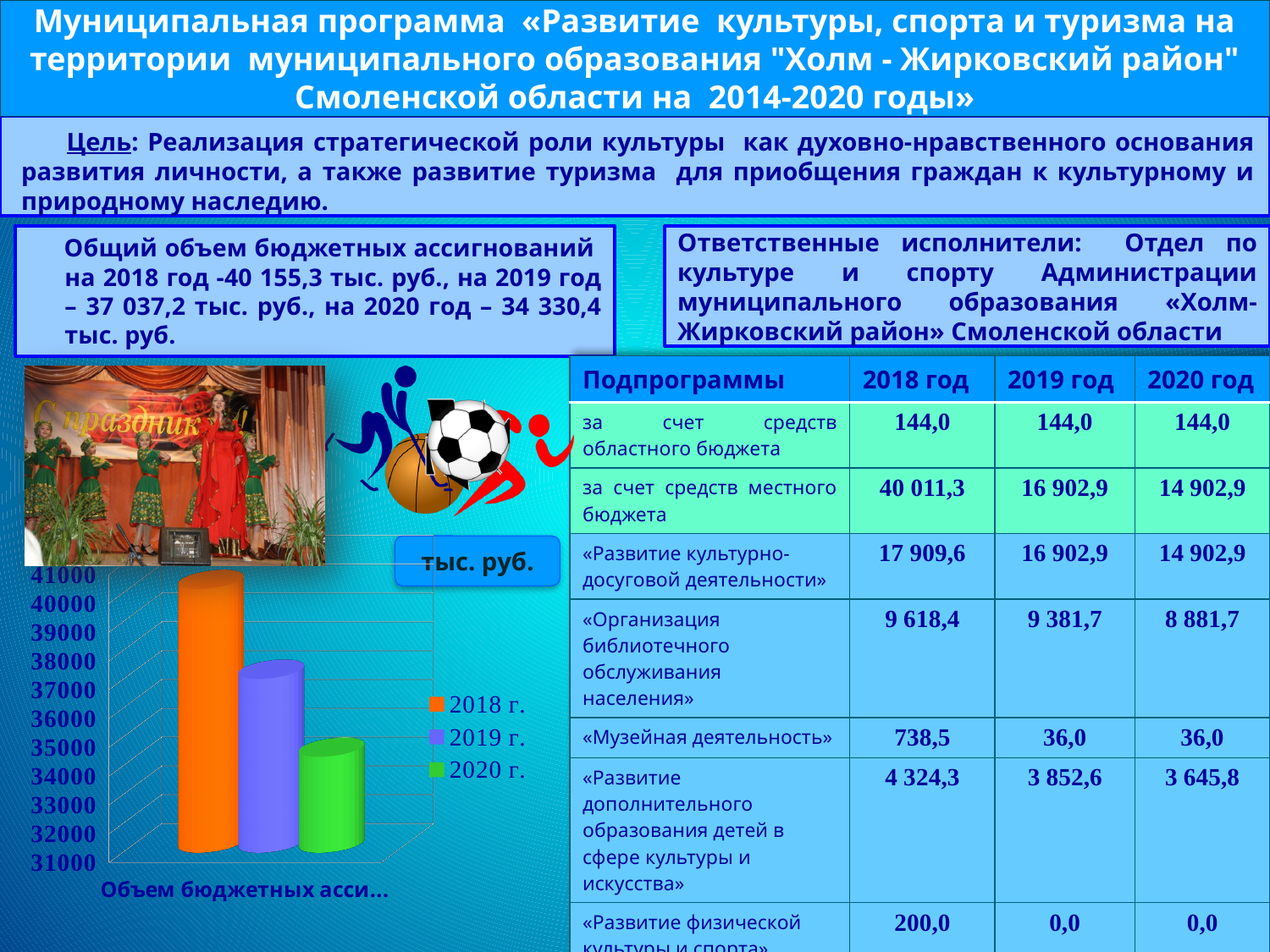
What colour is the bar for 2018 г. in the chart? orange Do the bar values rise or fall from 2018 г. to 2020 г.? fall What unit label is shown above the chart legend? тыс. руб. Which series has the lowest bar in the chart? 2020 г. How many series does the chart legend list? 3 Is the bar for 2018 г. greater or less than 40000? greater Is the bar for 2020 г. greater or less than 34000? greater Which is larger in the chart, the bar for 2019 г. or the bar for 2020 г.? 2019 г. Which series has the highest bar in the chart? 2018 г. What kind of chart is shown on the slide? bar chart